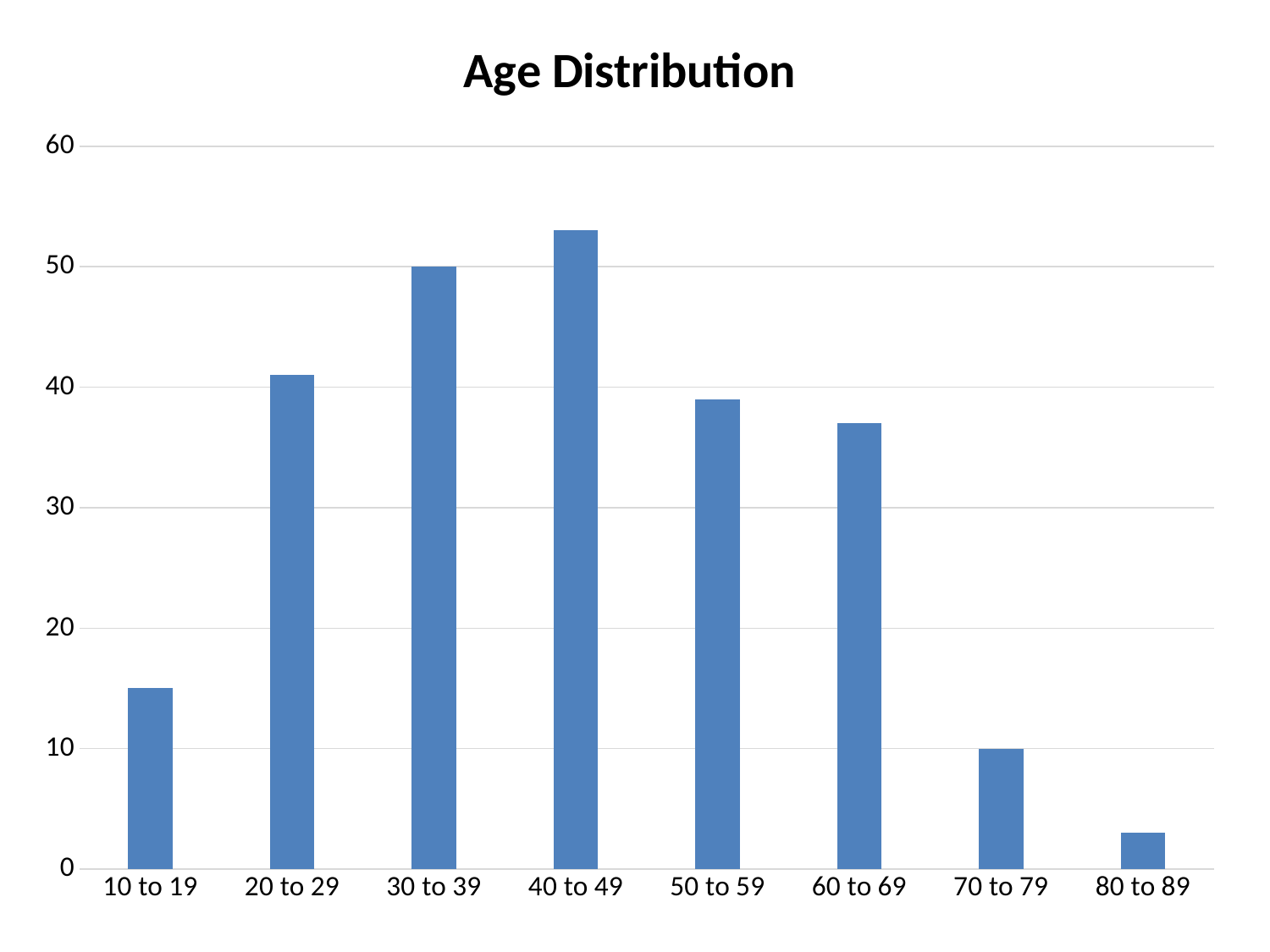
Is the value for 40 to 49 greater or less than 50? greater Is the value for 10 to 19 greater or less than 20? less Is the value for 80 to 89 greater or less than 10? less What is the title of the chart? Age Distribution What is the value for the 70 to 79 age group? 10 How many age categories are shown on the x axis? 8 Which age group has the highest value? 40 to 49 From the 40 to 49 group onward, do the values rise or fall along the x axis? fall Which is larger, the value for 10 to 19 or the value for 70 to 79? 10 to 19 What is the value for the 30 to 39 age group? 50 What type of chart is shown on the slide? bar chart Which age group has the lowest value? 80 to 89